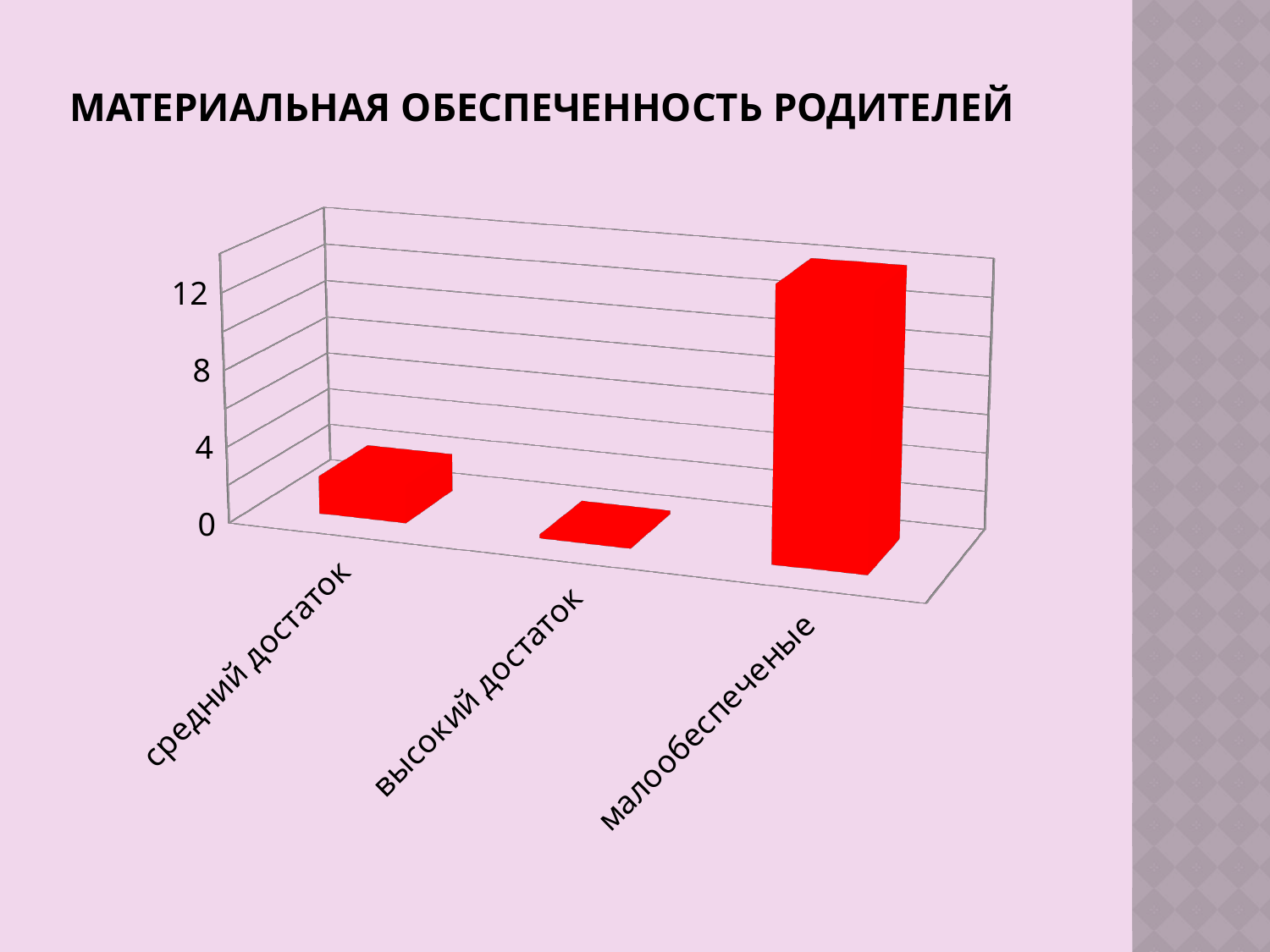
Which category has the highest value in the chart? малообеспеченые Which is larger, the value for средний достаток or the value for высокий достаток? средний достаток What kind of chart is shown on the slide? bar chart Which is larger, the value for малообеспеченые or the value for средний достаток? малообеспеченые Is the value for малообеспеченые greater or less than 8? greater Which category has the lowest value in the chart? высокий достаток What is the highest tick value shown on the vertical axis of the chart? 12 Is the value for высокий достаток greater or less than 4? less How many categories are shown on the x axis of the chart? 3 What is the title of the slide containing the chart? МАТЕРИАЛЬНАЯ ОБЕСПЕЧЕННОСТЬ РОДИТЕЛЕЙ What colour are the bars in the chart? red Is the value for средний достаток greater or less than 4? less